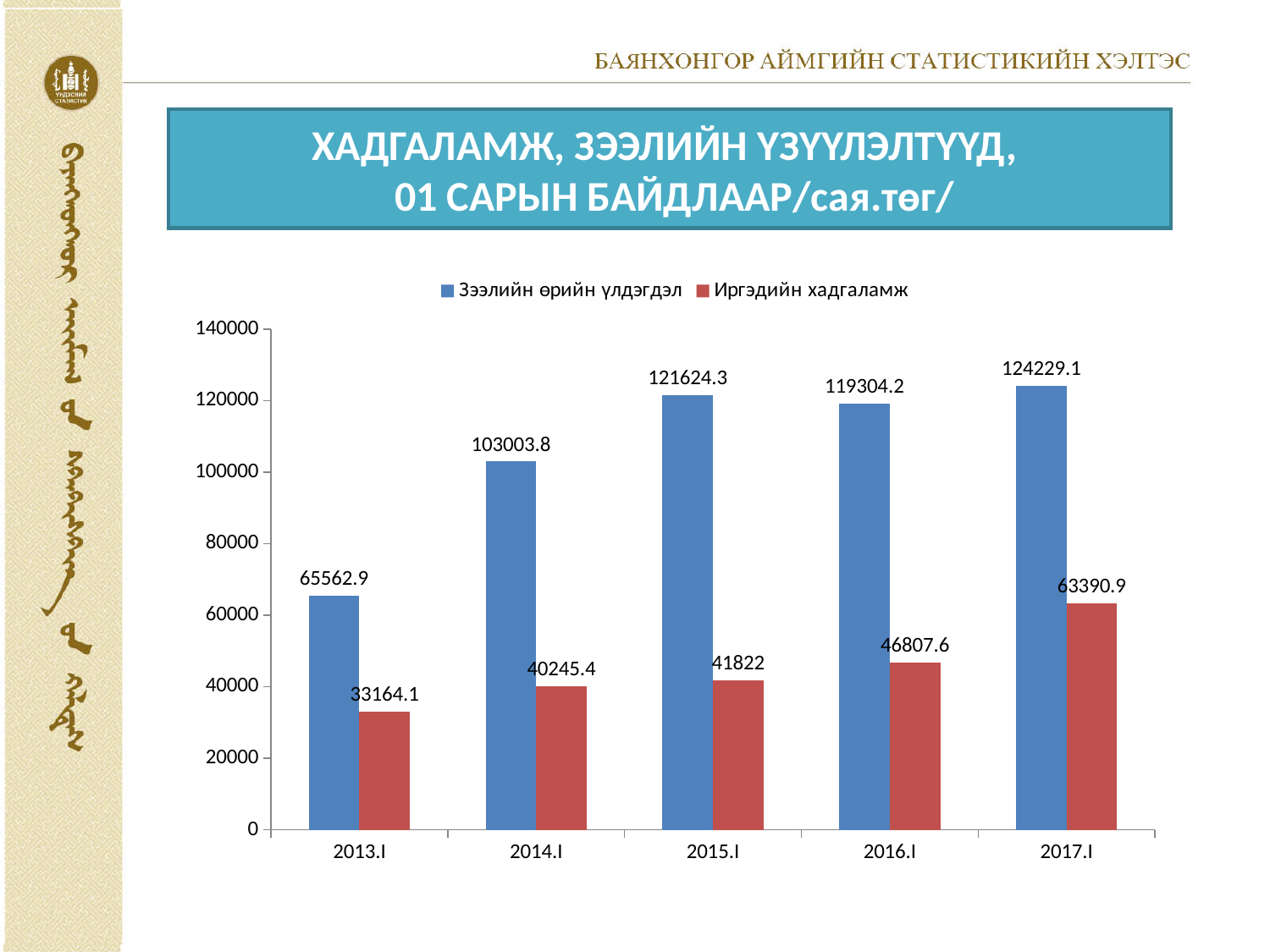
How many periods are shown on the x axis? 5 What is the difference between Зээлийн өрийн үлдэгдэл and Иргэдийн хадгаламж in 2017.I? 60838.2 In which period is Зээлийн өрийн үлдэгдэл highest? 2017.I Does Иргэдийн хадгаламж rise or fall from 2013.I to 2017.I? Rise What is the value of Иргэдийн хадгаламж for 2017.I? 63390.9 How many series does the legend list? 2 In which period is Иргэдийн хадгаламж lowest? 2013.I What is the value of Иргэдийн хадгаламж for 2013.I? 33164.1 Which is larger: Зээлийн өрийн үлдэгдэл in 2015.I or in 2016.I? 2015.I What is the value of Зээлийн өрийн үлдэгдэл for 2015.I? 121624.3 By how much did Иргэдийн хадгаламж increase from 2015.I to 2016.I? 4985.6 What kind of chart is shown on the slide? Bar chart